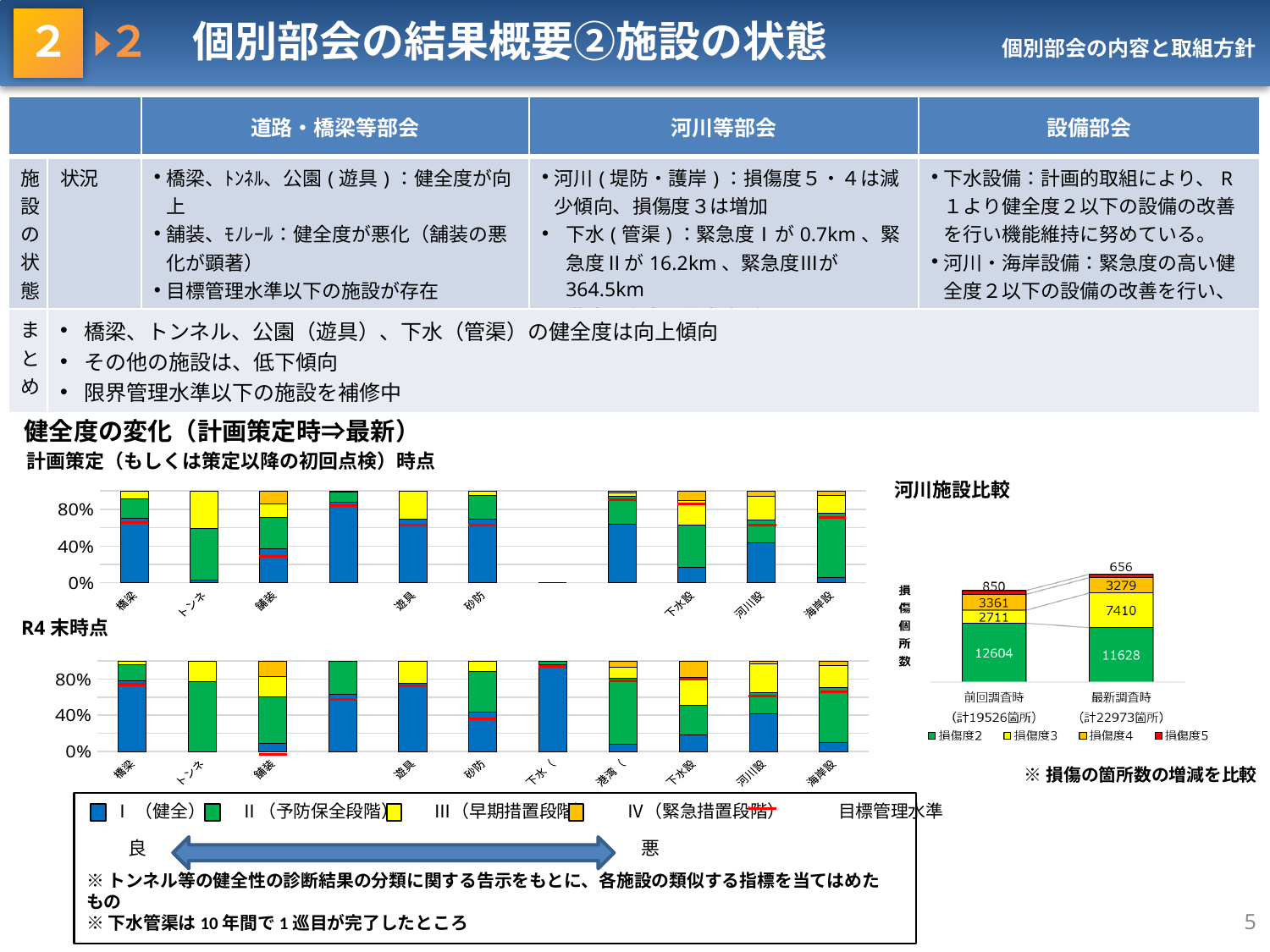
What kind of chart is the 河川施設比較 chart? Stacked bar chart How many series does the legend of the 河川施設比較 chart list? 4 In the 河川施設比較 chart, what is the value for 損傷度3 at 最新調査時? 7410 In the 河川施設比較 chart, what is the value for 損傷度2 at 前回調査時? 12604 In the 河川施設比較 chart, what is the difference between 損傷度3 at 最新調査時 and 損傷度3 at 前回調査時? 4699 In the 河川施設比較 chart, what is the total of the 前回調査時 stacked bar? 19526 In the 河川施設比較 chart, which damage level has the smallest value at 最新調査時? 損傷度5 In the 河川施設比較 chart, which is larger: 損傷度2 at 前回調査時 or 損傷度2 at 最新調査時? 前回調査時 In the 河川施設比較 chart, what is the value for 損傷度4 at 最新調査時? 3279 In the 河川施設比較 chart, what is the total of the 最新調査時 stacked bar? 22973 In the 河川施設比較 chart, what is the value for 損傷度5 at 前回調査時? 850 In the 計画策定（もしくは策定以降の初回点検）時点 chart, is the blue (I 健全) share for 橋梁 greater or less than 40%? greater